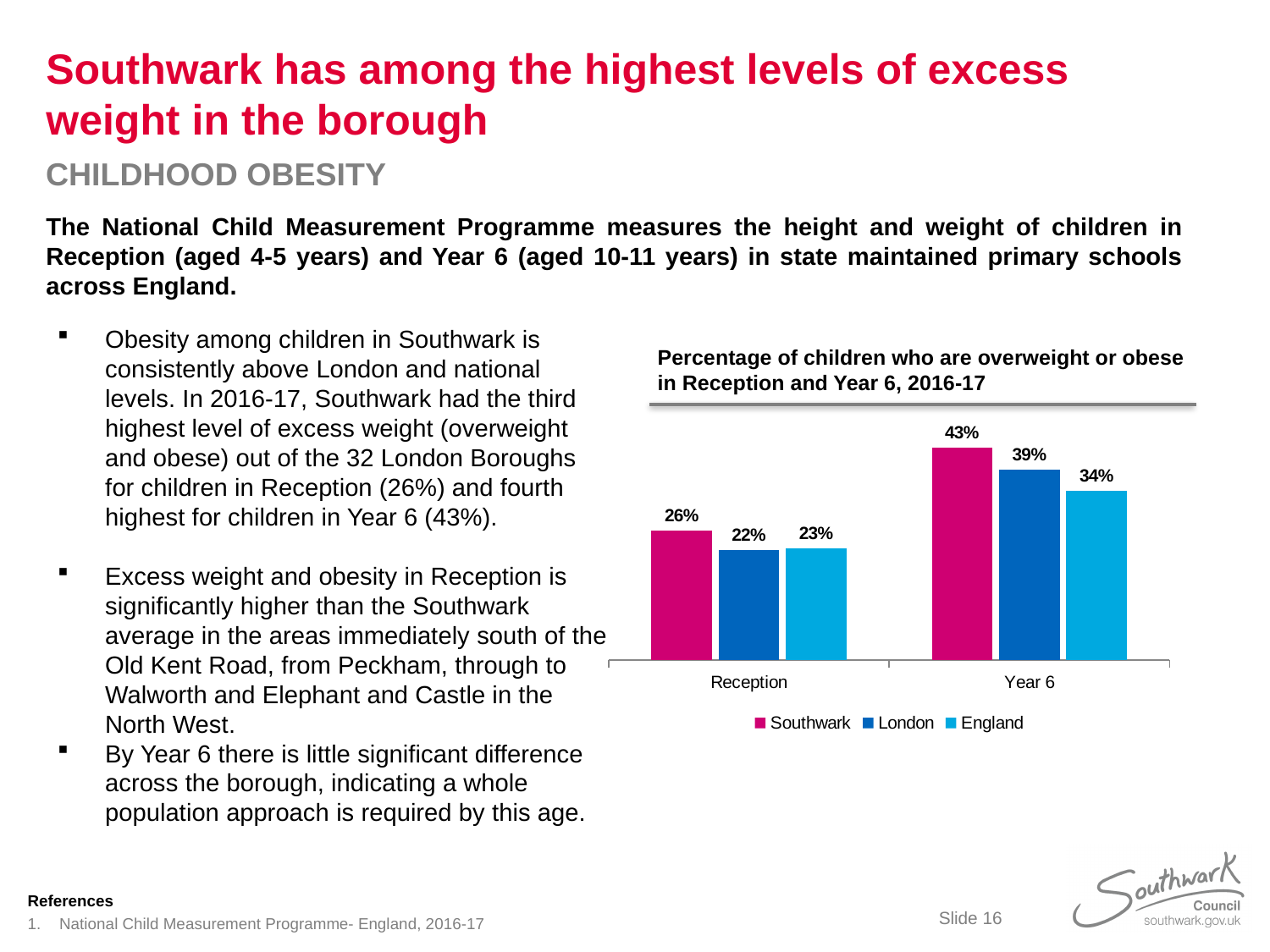
Which series has the lowest value in Reception? London What is the value for England in Year 6? 34% What is the difference between the Southwark values for Year 6 and Reception? 17% How many series does the legend list? 3 Which series has the highest value in Year 6? Southwark Is the value for England in Reception larger or smaller than the value for England in Year 6? smaller What is the title of the chart? Percentage of children who are overweight or obese in Reception and Year 6, 2016-17 How many categories are shown on the x axis? 2 What percentage of children in Reception in Southwark are overweight or obese? 26% What is the difference between the Southwark and London values in Year 6? 4% What kind of chart is shown on the slide? bar chart What is the value for London in Reception? 22%